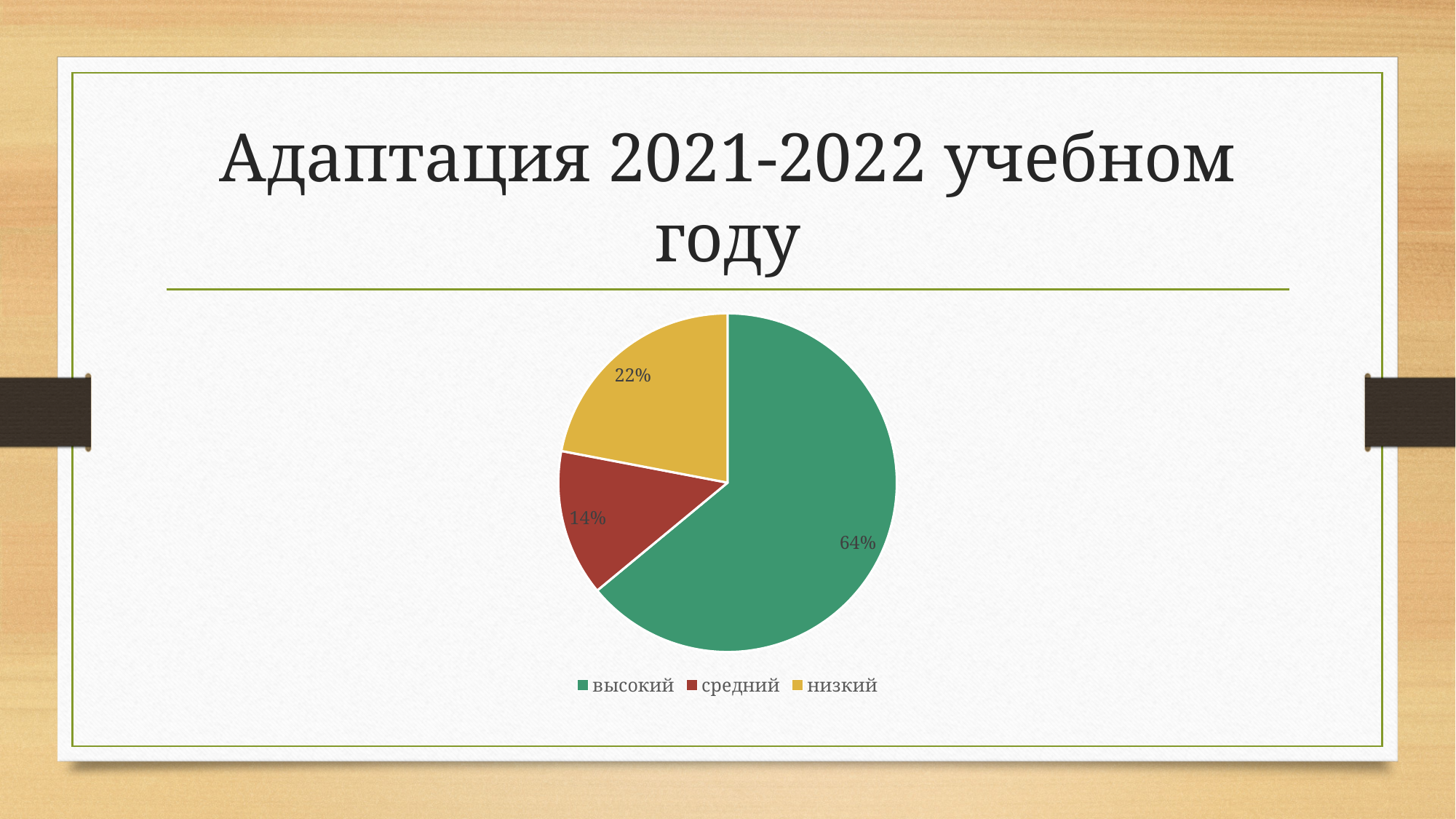
What is the value for низкий? 22% What kind of chart is shown on the slide? pie chart What is the difference between the values for низкий and средний? 8% What is the difference between the values for высокий and низкий? 42% What is the value for высокий? 64% Which category has the largest slice? высокий Which is larger, the value for низкий or the value for средний? низкий What colour is the slice for средний? red How many slices does the pie chart have? 3 What is the value for средний? 14% Which category has the smallest slice? средний What is the title of the slide containing the chart? Адаптация 2021-2022 учебном году